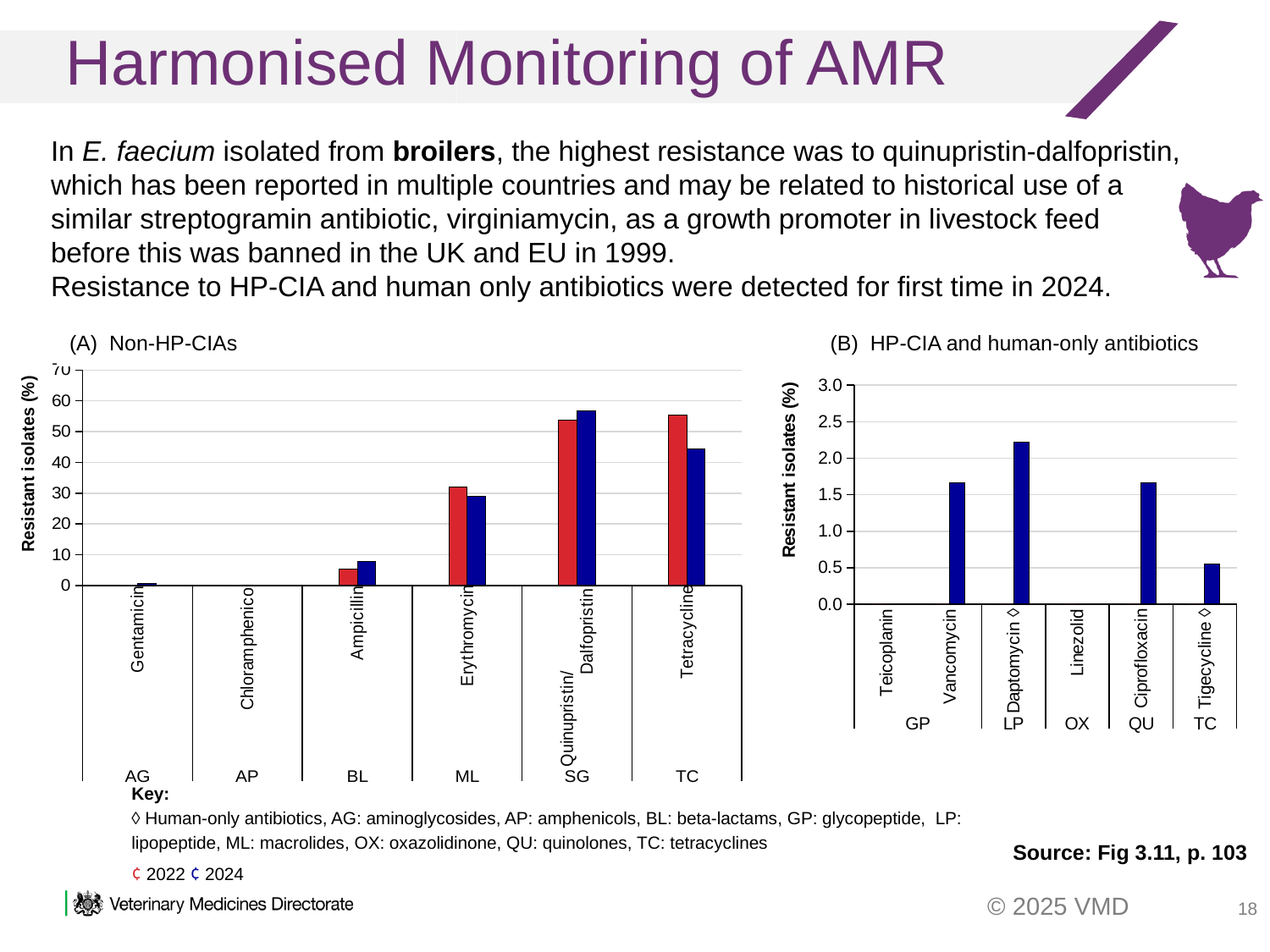
In chart (B) HP-CIA and human-only antibiotics, is the value for Daptomycin greater or less than 2.0? greater In chart (A) Non-HP-CIAs, is the 2022 value for Tetracycline greater or less than 50? greater In chart (A) Non-HP-CIAs, which antibiotic has the highest resistance in 2024? Quinupristin/Dalfopristin How many antibiotic categories are shown in chart (B) HP-CIA and human-only antibiotics? 6 In chart (B) HP-CIA and human-only antibiotics, which antibiotic has the highest percentage of resistant isolates? Daptomycin What kind of chart is chart (A) Non-HP-CIAs? Bar chart What is the y-axis label of chart (B) HP-CIA and human-only antibiotics? Resistant isolates (%) In chart (A) Non-HP-CIAs, which year has the larger value for Tetracycline, 2022 or 2024? 2022 How many series does the key list for chart (A) Non-HP-CIAs? 2 In chart (A) Non-HP-CIAs, is the 2024 value for Ampicillin greater or less than 10? less How many antibiotic categories are shown in chart (A) Non-HP-CIAs? 6 In chart (A) Non-HP-CIAs, which year has the larger value for Quinupristin/Dalfopristin, 2022 or 2024? 2024